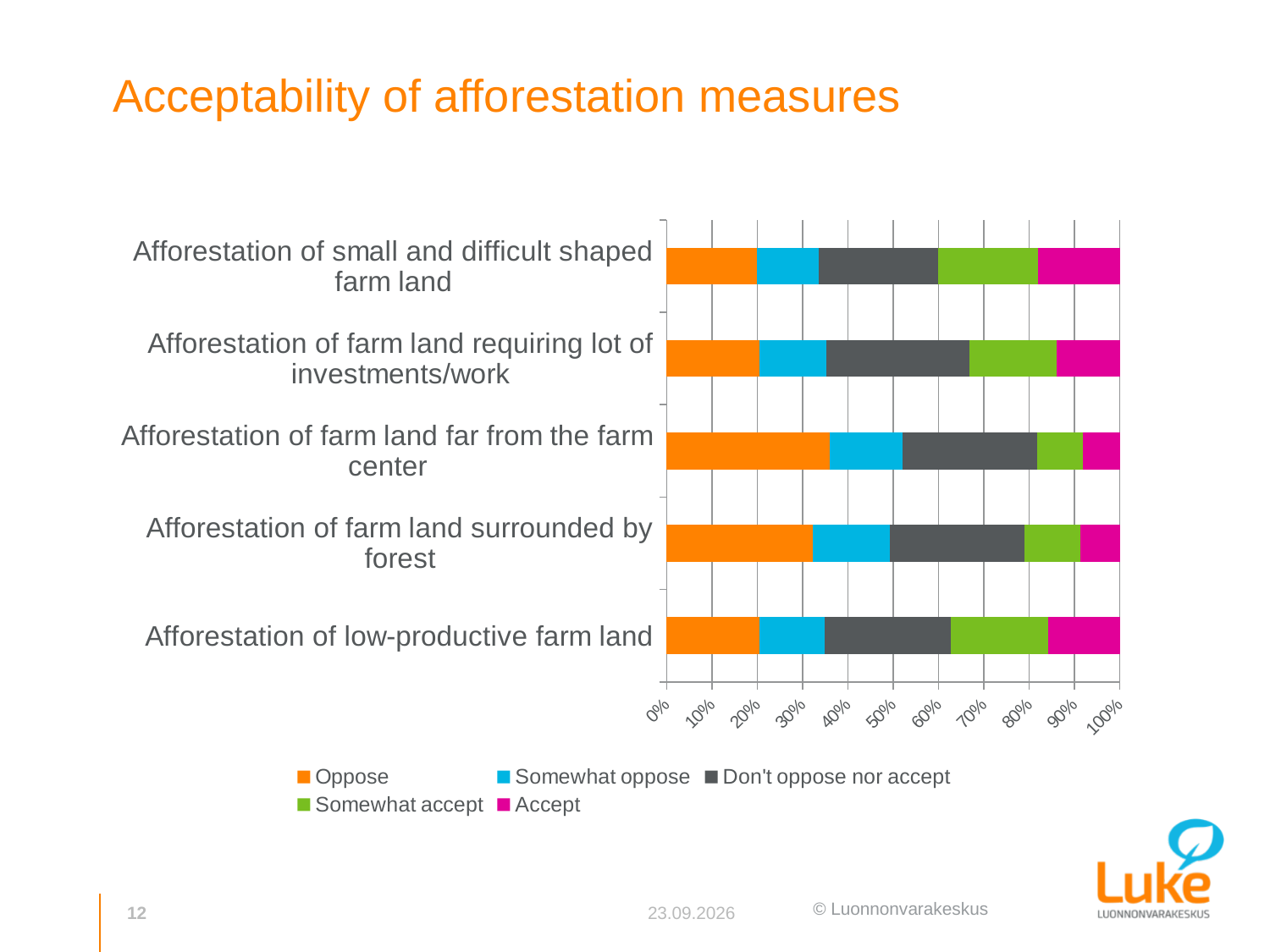
What value does each stacked bar in the chart add up to? 100% Which colour represents the 'Oppose' series in the legend? orange What is the title of the slide containing the chart? Acceptability of afforestation measures Is the 'Oppose' share for 'Afforestation of farm land far from the farm center' greater or less than 30%? greater Which has the larger 'Oppose' share: 'Afforestation of farm land surrounded by forest' or 'Afforestation of low-productive farm land'? Afforestation of farm land surrounded by forest What kind of chart is shown on the slide? bar chart How many afforestation measures (categories) are plotted in the chart? 5 Which has the larger 'Accept' share: 'Afforestation of small and difficult shaped farm land' or 'Afforestation of farm land far from the farm center'? Afforestation of small and difficult shaped farm land Is the 'Accept' share for 'Afforestation of farm land far from the farm center' greater or less than 20%? less Is the 'Oppose' share for 'Afforestation of small and difficult shaped farm land' greater or less than 30%? less How many series does the legend list? 5 Which afforestation measure has the largest 'Oppose' share? Afforestation of farm land far from the farm center